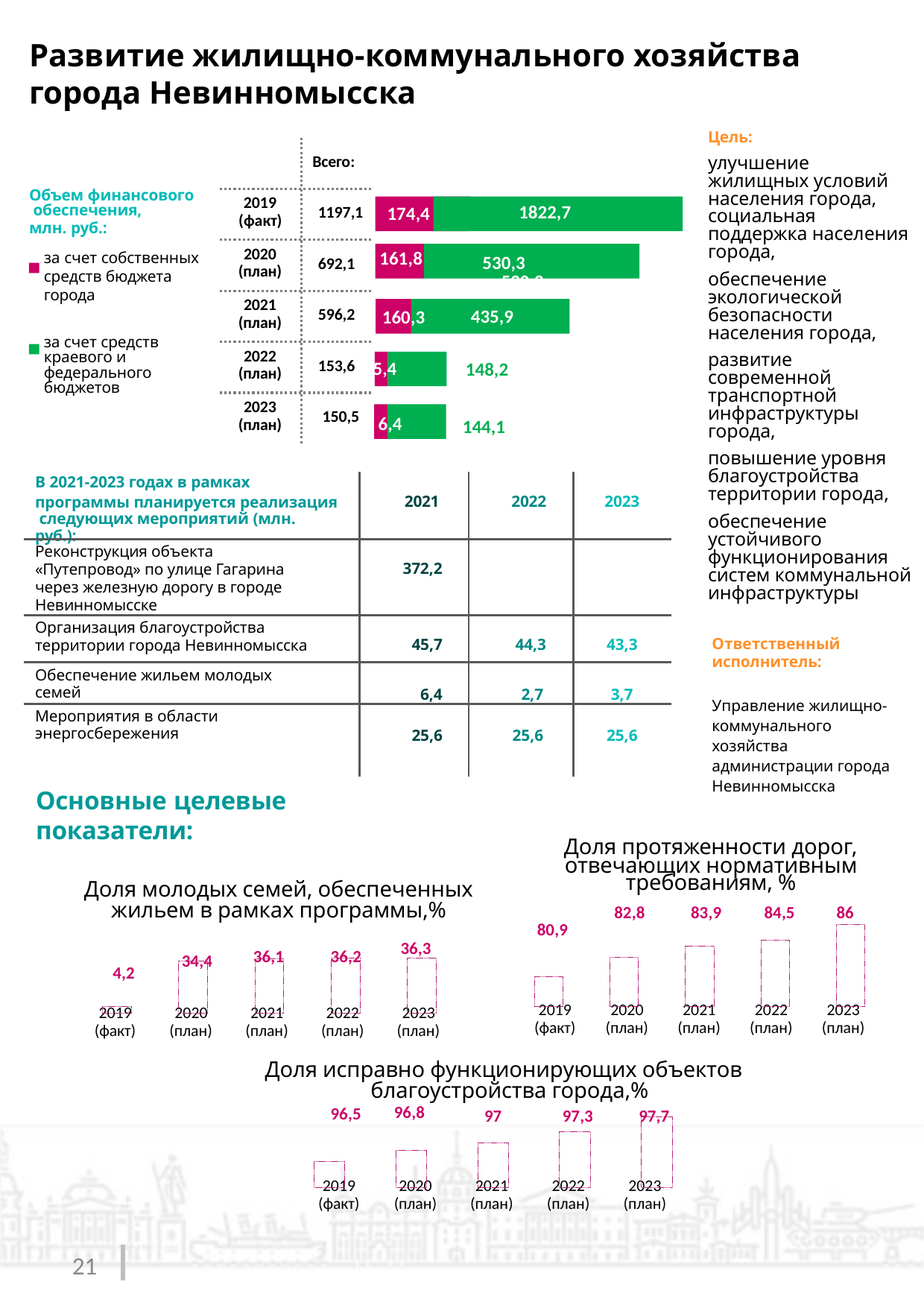
In the chart 'Доля протяженности дорог, отвечающих нормативным требованиям, %', do the values rise or fall from 2019 to 2023? Rise In the chart 'Объем финансового обеспечения, млн. руб.', what is the total ('Всего') for 2023 (план)? 150,5 In the chart 'Объем финансового обеспечения, млн. руб.', what is the value for 'за счет средств краевого и федерального бюджетов' in 2022 (план)? 148,2 In the chart 'Доля молодых семей, обеспеченных жильем в рамках программы,%', what is the difference between the 2023 (план) and 2019 (факт) values? 32,1 What kind of chart is 'Объем финансового обеспечения, млн. руб.'? Stacked bar chart In the chart 'Объем финансового обеспечения, млн. руб.', which year has the highest total? 2019 (факт) In the chart 'Объем финансового обеспечения, млн. руб.', what is the value for 'за счет собственных средств бюджета города' in 2021 (план)? 160,3 In the chart 'Доля исправно функционирующих объектов благоустройства города,%', what is the value for 2021 (план)? 97 In the chart 'Доля молодых семей, обеспеченных жильем в рамках программы,%', what is the value for 2019 (факт)? 4,2 In the chart 'Объем финансового обеспечения, млн. руб.', how many series does the legend list? 2 How many years (categories) are shown in the chart 'Доля исправно функционирующих объектов благоустройства города,%'? 5 In the chart 'Доля протяженности дорог, отвечающих нормативным требованиям, %', which year has the highest value? 2023 (план)